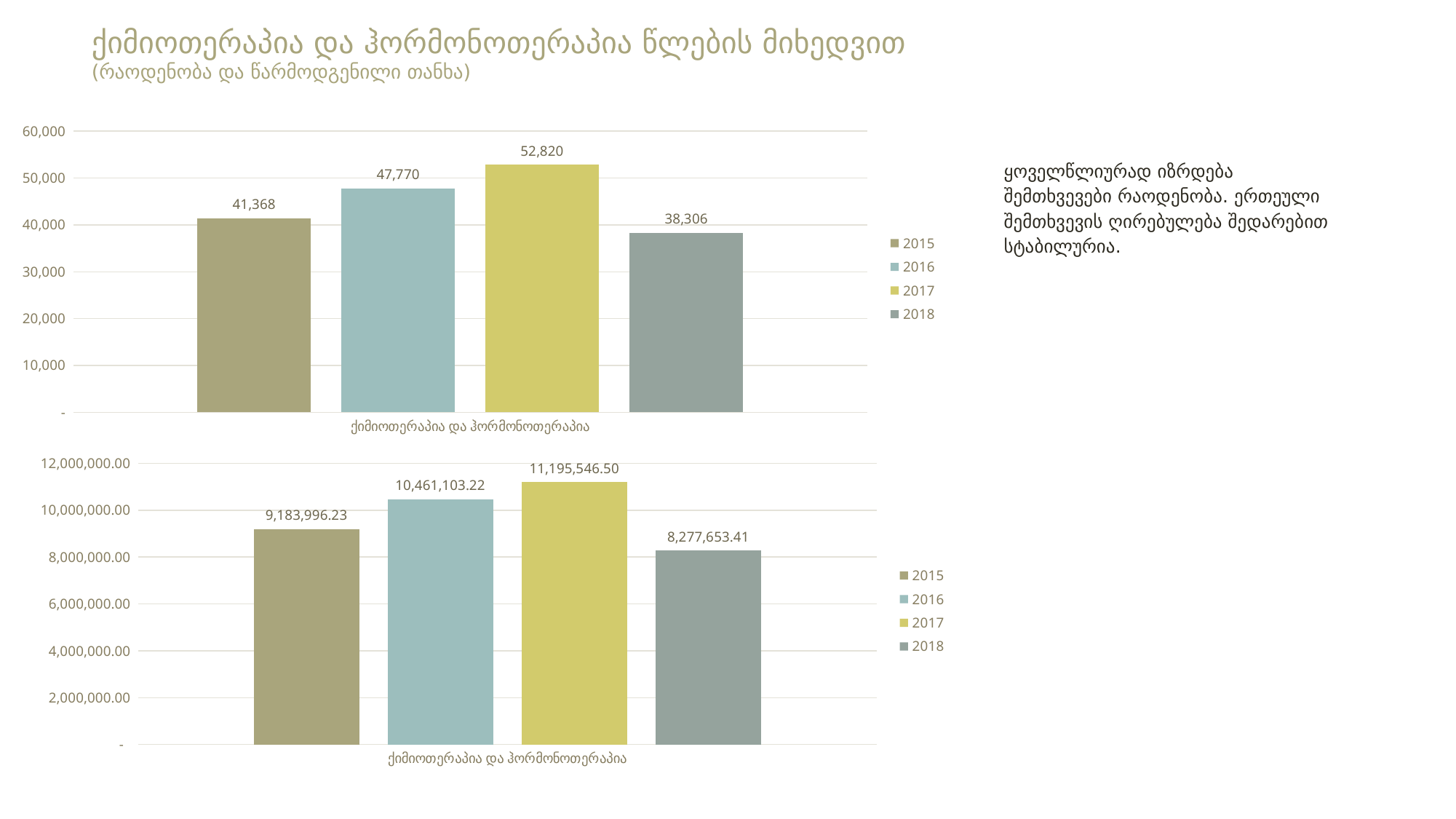
In the top chart, which year has the highest value? 2017 In the top chart, which is larger, the value for 2015 or the value for 2016? 2016 In the top chart, what is the value for 2018? 38,306 What kind of chart is the bottom chart? bar chart In the top chart, what is the value for 2017? 52,820 How many series does the legend of the top chart list? 4 In the bottom chart, which year has the lowest value? 2018 In the bottom chart, is the value for 2017 greater or less than 10,000,000.00? greater In the bottom chart, what is the difference between the values for 2016 and 2015? 1,277,106.99 In the top chart, what is the difference between the values for 2017 and 2018? 14,514 In the bottom chart, what is the value for 2015? 9,183,996.23 In the bottom chart, what is the value for 2016? 10,461,103.22